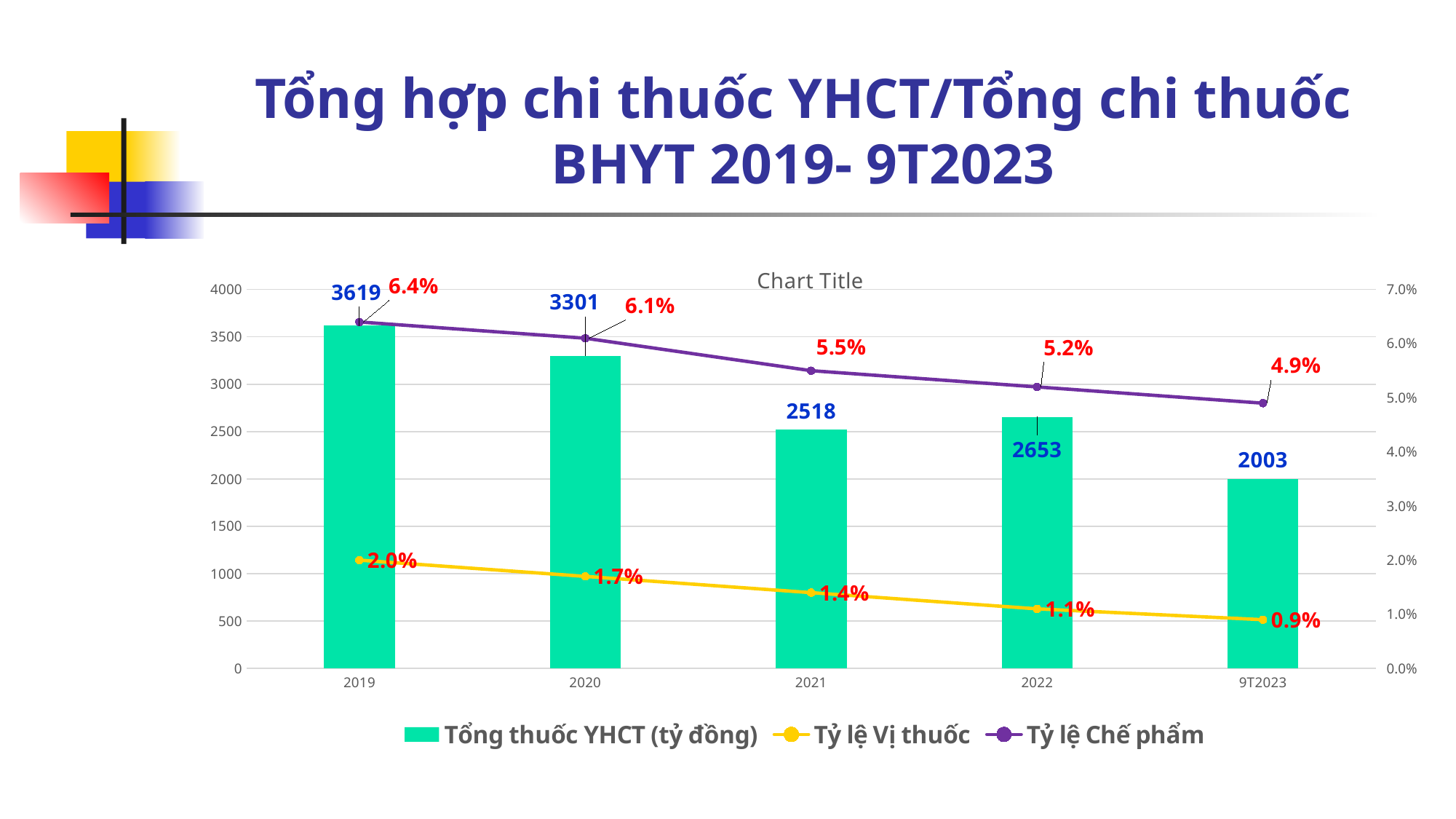
What is the value of Tổng thuốc YHCT (tỷ đồng) for 9T2023? 2003 Which year has the highest Tổng thuốc YHCT (tỷ đồng) value? 2019 Which category has the lowest Tỷ lệ Chế phẩm value? 9T2023 Does the Tỷ lệ Vị thuốc series rise or fall from 2019 to 9T2023? fall What is the value of Tổng thuốc YHCT (tỷ đồng) for 2019? 3619 How many categories are shown on the x axis? 5 How many series does the legend list? 3 What is the Tỷ lệ Vị thuốc value for 2022? 1.1% What is the difference between the Tổng thuốc YHCT (tỷ đồng) values for 2019 and 2020? 318 What colour are the Tổng thuốc YHCT (tỷ đồng) bars? green Which is larger, the Tổng thuốc YHCT (tỷ đồng) value for 2021 or for 2022? 2022 What is the Tỷ lệ Chế phẩm value for 2021? 5.5%